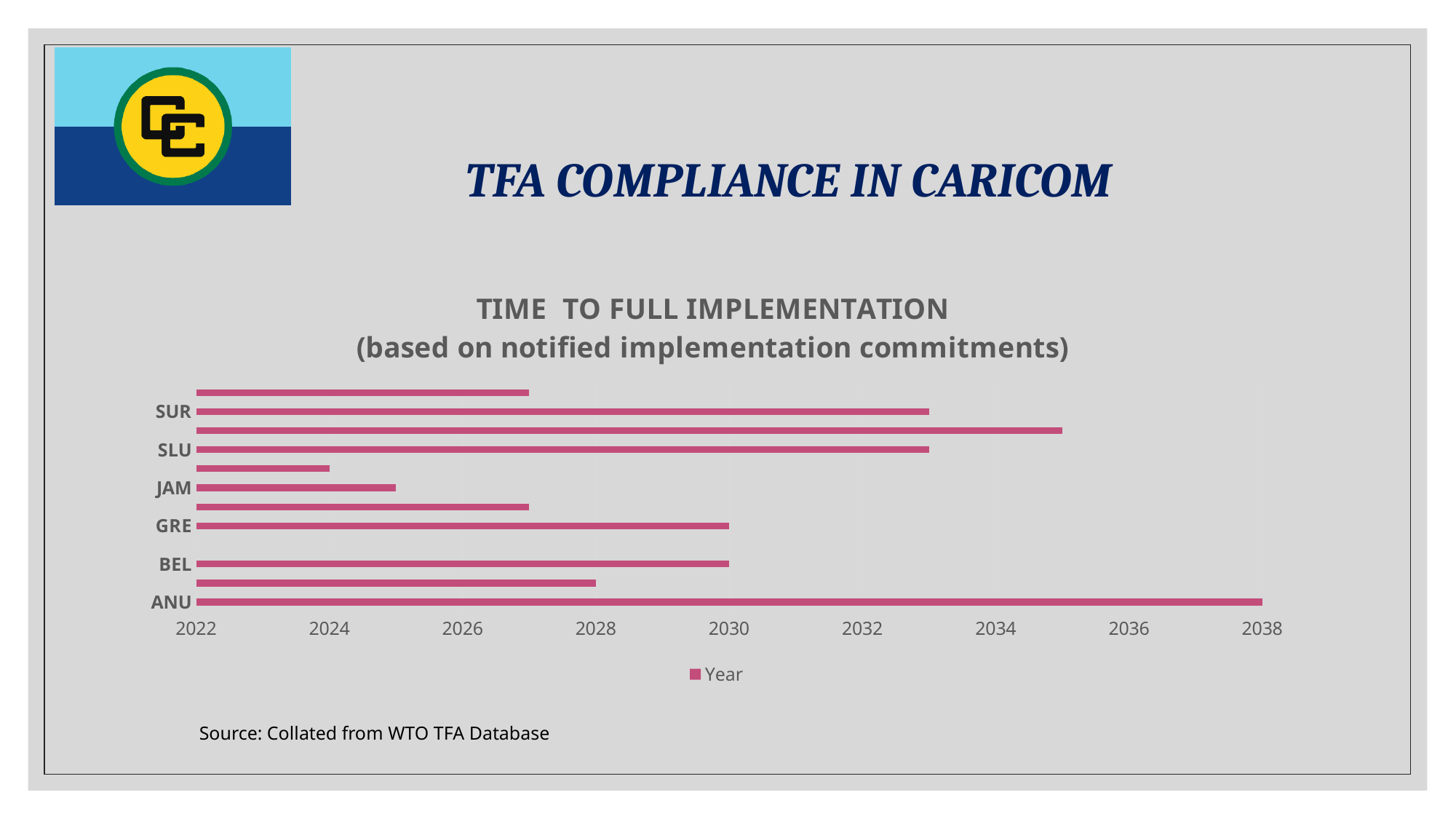
What is the value for BEL? 2030 How many category labels are shown on the vertical axis? 6 What is the value for ANU? 2038 Among the labelled categories, which has the shortest bar? JAM What is the single entry listed in the chart legend? Year Is the value for SLU greater or less than 2030? greater Which is larger, the value for SUR or the value for JAM? SUR Which category has the longest bar? ANU What is the value for GRE? 2030 Is the value for SUR greater or less than 2032? greater What kind of chart is shown on the slide? bar chart Is the value for JAM greater or less than 2026? less